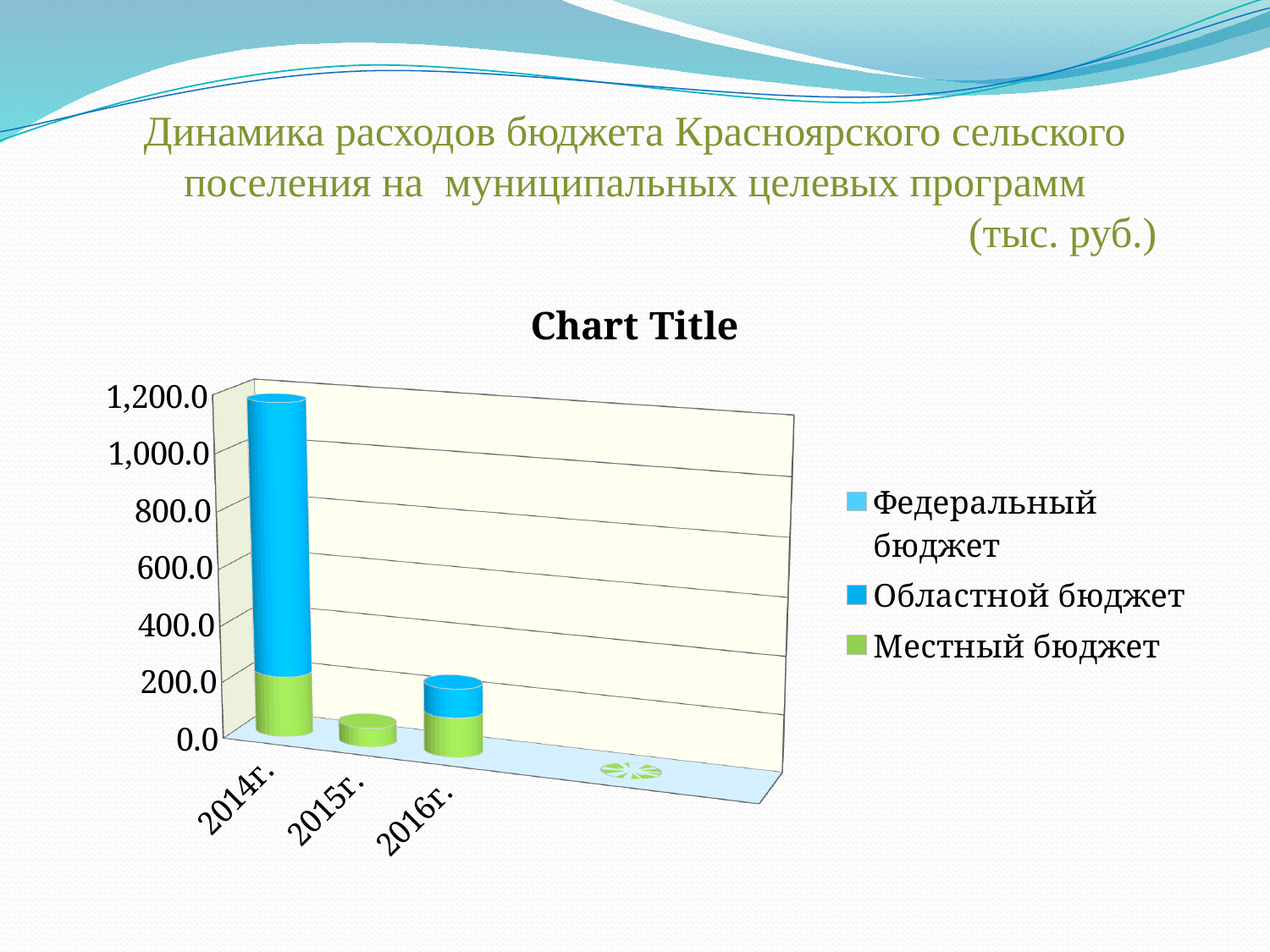
How many year categories are shown on the x axis of the chart? 3 How many series does the chart legend list? 3 Does the total bar rise or fall from 2014г. to 2015г.? fall Which year has the highest total bar in the chart? 2014г. Is the total bar for 2015г. greater or less than 200.0? less What kind of chart is shown on the slide? bar chart Is the total bar for 2016г. greater or less than 400.0? less Is the Местный бюджет segment for 2014г. greater or less than 400.0? less Which total bar is larger, 2014г. or 2016г.? 2014г. What is the title printed above the chart? Chart Title Which year has the lowest total bar in the chart? 2015г.